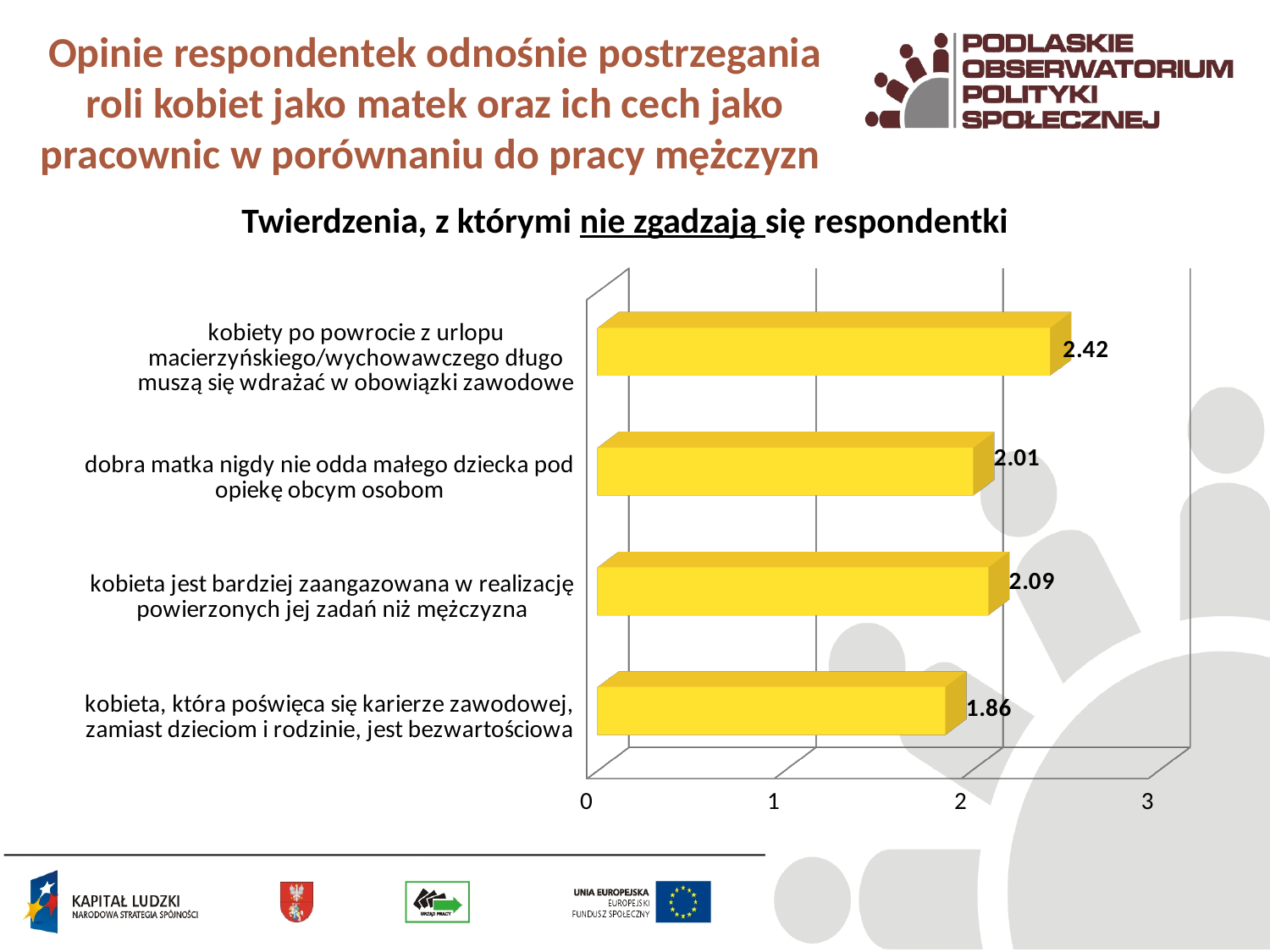
What value is shown for the statement "kobieta, która poświęca się karierze zawodowej, zamiast dzieciom i rodzinie, jest bezwartościowa"? 1.86 What value is shown for the statement "dobra matka nigdy nie odda małego dziecka pod opiekę obcym osobom"? 2.01 How many statements (bars) are shown in the chart? 4 What is the difference between the highest value (2.42) and the lowest value (1.86) in the chart? 0.56 What is the maximum value shown on the chart's value axis? 3 What kind of chart is shown on the slide? bar chart Is the value for "kobieta, która poświęca się karierze zawodowej, zamiast dzieciom i rodzinie, jest bezwartościowa" greater or less than 2? less Which statement has the highest value in the chart? kobiety po powrocie z urlopu macierzyńskiego/wychowawczego długo muszą się wdrażać w obowiązki zawodowe Which statement has the lowest value in the chart? kobieta, która poświęca się karierze zawodowej, zamiast dzieciom i rodzinie, jest bezwartościowa What value is shown for the statement "kobiety po powrocie z urlopu macierzyńskiego/wychowawczego długo muszą się wdrażać w obowiązki zawodowe"? 2.42 Which has a larger value: "dobra matka nigdy nie odda małego dziecka pod opiekę obcym osobom" or "kobieta jest bardziej zaangazowana w realizację powierzonych jej zadań niż mężczyzna"? kobieta jest bardziej zaangazowana w realizację powierzonych jej zadań niż mężczyzna What is the title of the chart? Twierdzenia, z którymi nie zgadzają się respondentki